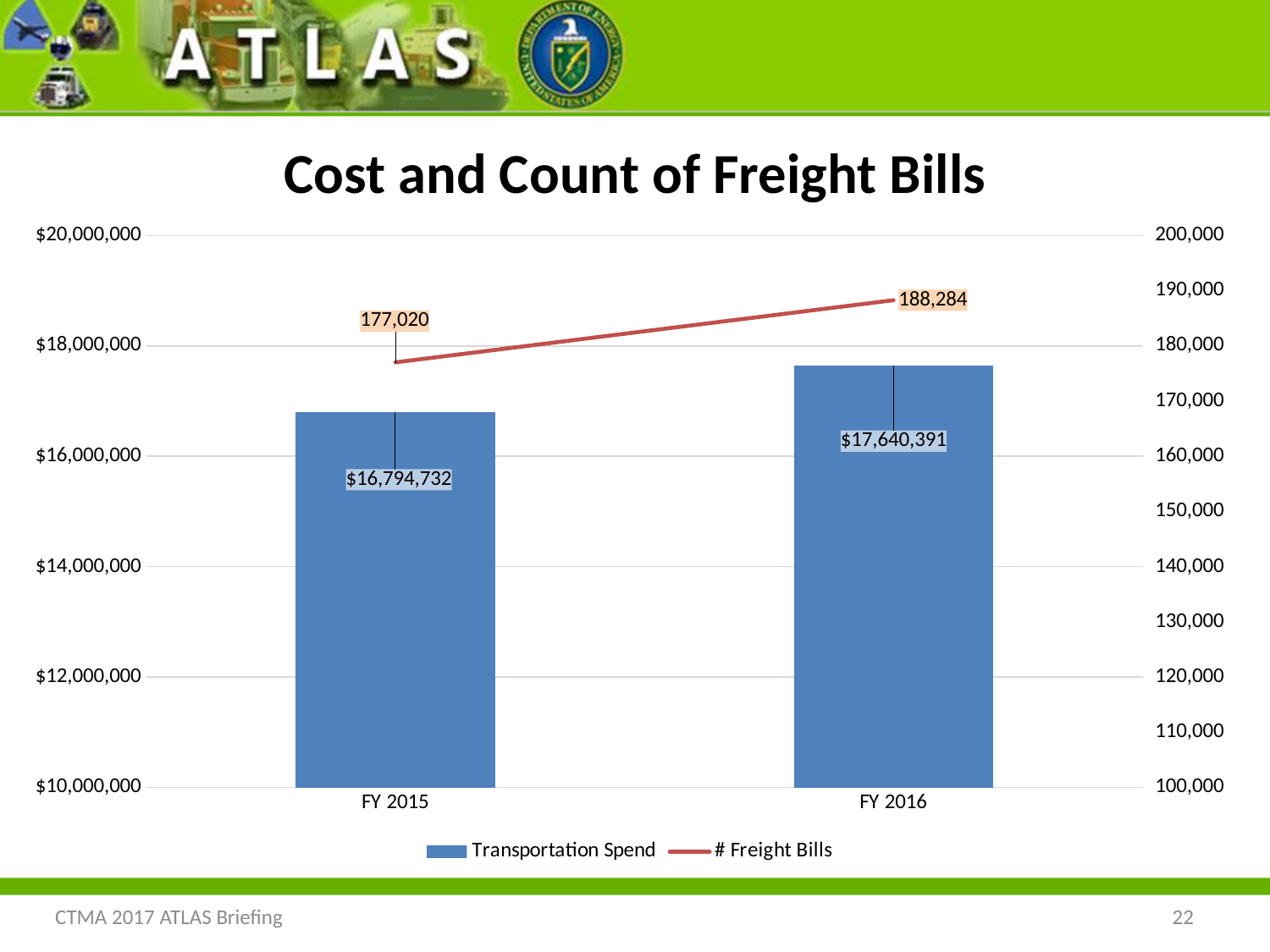
By how much did Transportation Spend increase from FY 2015 to FY 2016? $845,659 Which fiscal year has the higher Transportation Spend? FY 2016 What is the title of the chart? Cost and Count of Freight Bills What is the Transportation Spend for FY 2016? $17,640,391 What is the difference in the number of freight bills between FY 2016 and FY 2015? 11,264 How many freight bills were there in FY 2015? 177,020 How many series does the legend list? 2 How many freight bills were there in FY 2016? 188,284 How many fiscal years are shown on the x axis? 2 What is the Transportation Spend for FY 2015? $16,794,732 Does the number of freight bills rise or fall from FY 2015 to FY 2016? rise Which fiscal year has the lower number of freight bills? FY 2015